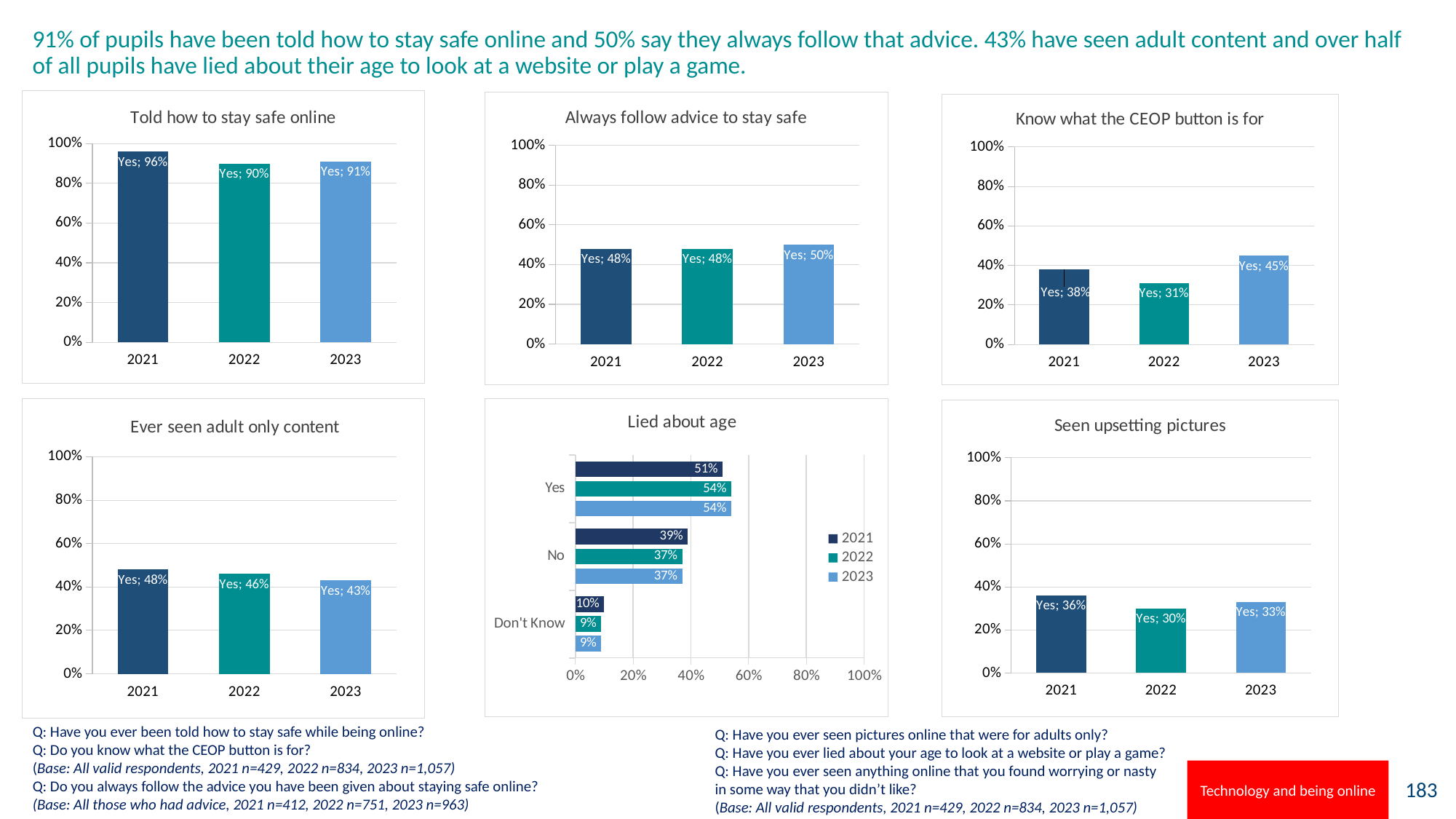
In the 'Lied about age' chart, what is the 2022 value for 'No'? 37% In the 'Ever seen adult only content' chart, what is the value for 2022? 46% In the 'Lied about age' chart, how many series does the legend list? 3 In the 'Seen upsetting pictures' chart, which is larger, the value for 2021 or the value for 2022? 2021 In the 'Always follow advice to stay safe' chart, what is the value for 2023? 50% In the 'Told how to stay safe online' chart, what is the value for 2021? 96% In the 'Know what the CEOP button is for' chart, what is the difference between the 2023 and 2022 values? 14% In the 'Lied about age' chart, how many response categories are shown on the vertical axis? 3 In the 'Ever seen adult only content' chart, do the values rise or fall from 2021 to 2023? fall In the 'Know what the CEOP button is for' chart, which year has the highest value? 2023 In the 'Told how to stay safe online' chart, which year has the lowest value? 2022 What kind of chart is the 'Lied about age' chart? bar chart